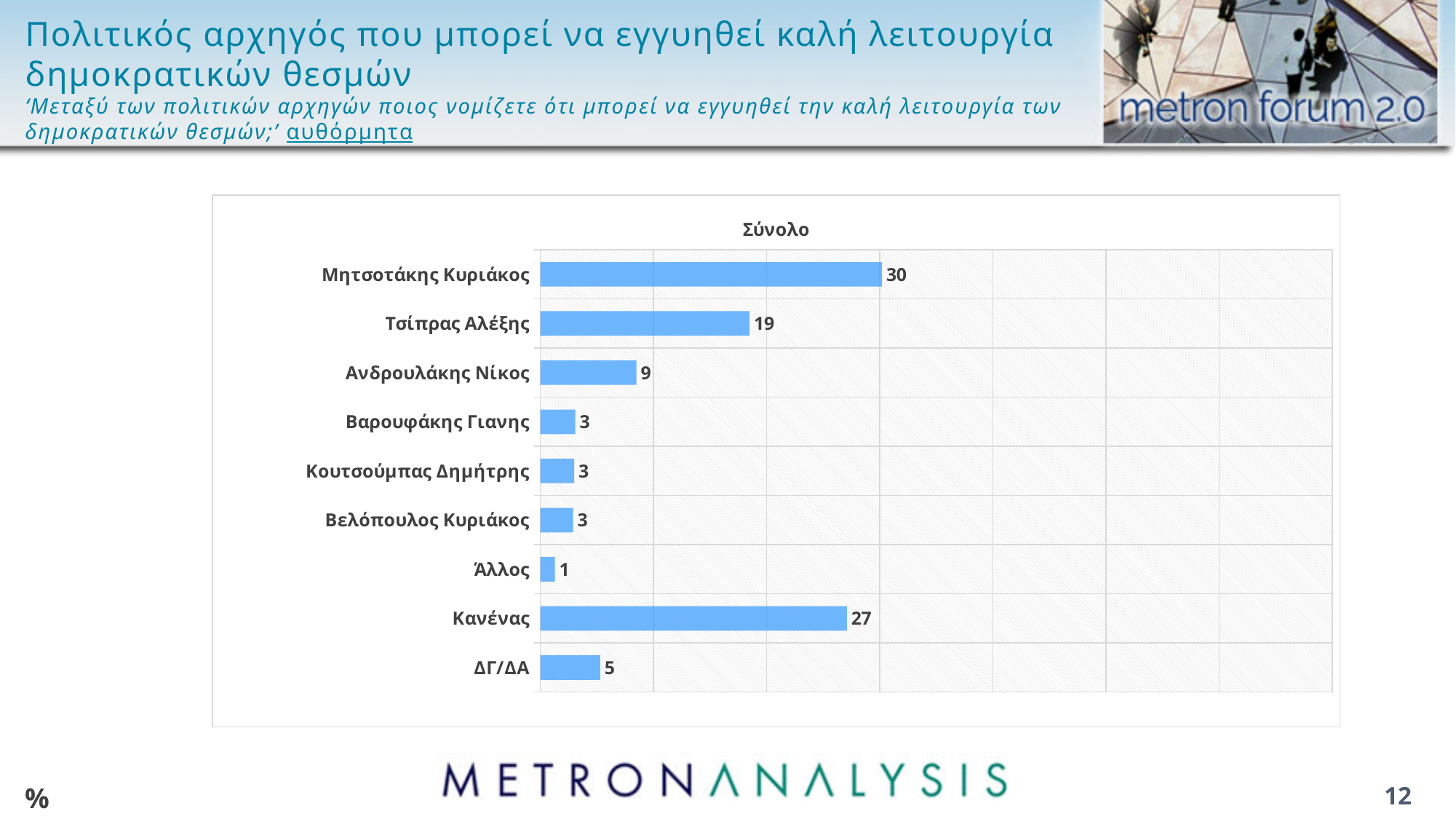
What is the value for ΔΓ/ΔΑ? 5 What is the value for Μητσοτάκης Κυριάκος? 30 What is the value for Κανένας? 27 What is the title of the chart? Σύνολο What is the difference between the values for Μητσοτάκης Κυριάκος and Τσίπρας Αλέξης? 11 What is the value for Τσίπρας Αλέξης? 19 What kind of chart is shown on the slide? Bar chart Which is larger, the value for Κανένας or the value for Τσίπρας Αλέξης? Κανένας Which category has the lowest value? Άλλος Which category has the highest value? Μητσοτάκης Κυριάκος What is the difference between the values for Κανένας and Ανδρουλάκης Νίκος? 18 How many categories are shown in the chart? 9